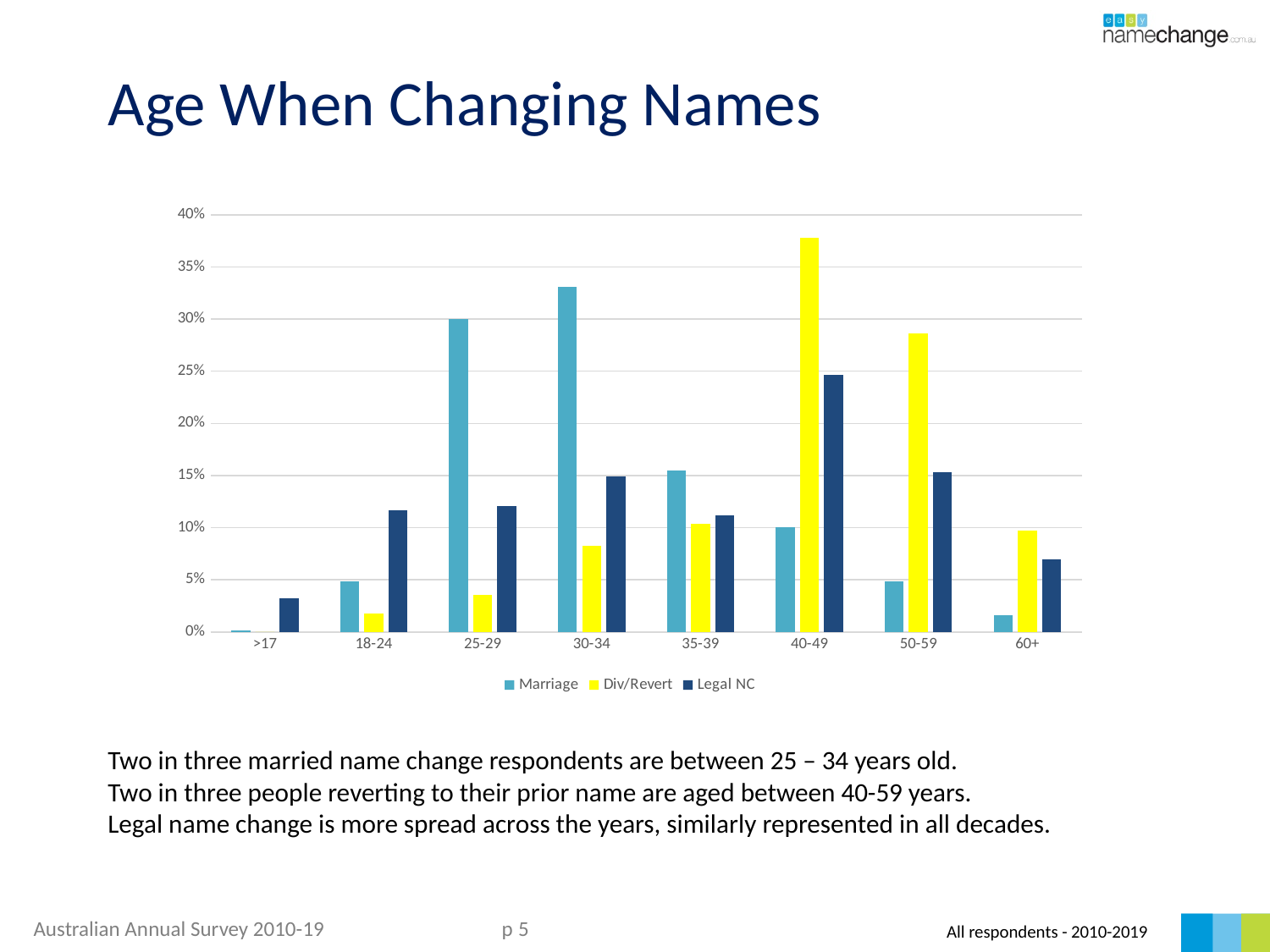
Which age group has the highest value for the Marriage series? 30-34 Is the Div/Revert value for 40-49 greater or less than 35%? greater How many series does the legend list? 3 Which age group has the highest value for the Div/Revert series? 40-49 Is the Legal NC value for 40-49 greater or less than 20%? greater Which series is shown in yellow in the legend? Div/Revert For the 25-29 age group, which series has the larger value, Marriage or Legal NC? Marriage How many age categories are shown on the x axis? 8 Which age group has the highest value for the Legal NC series? 40-49 Is the Marriage value for 18-24 greater or less than 10%? less For the 50-59 age group, which series has the larger value, Marriage or Div/Revert? Div/Revert What kind of chart is shown on the slide? bar chart